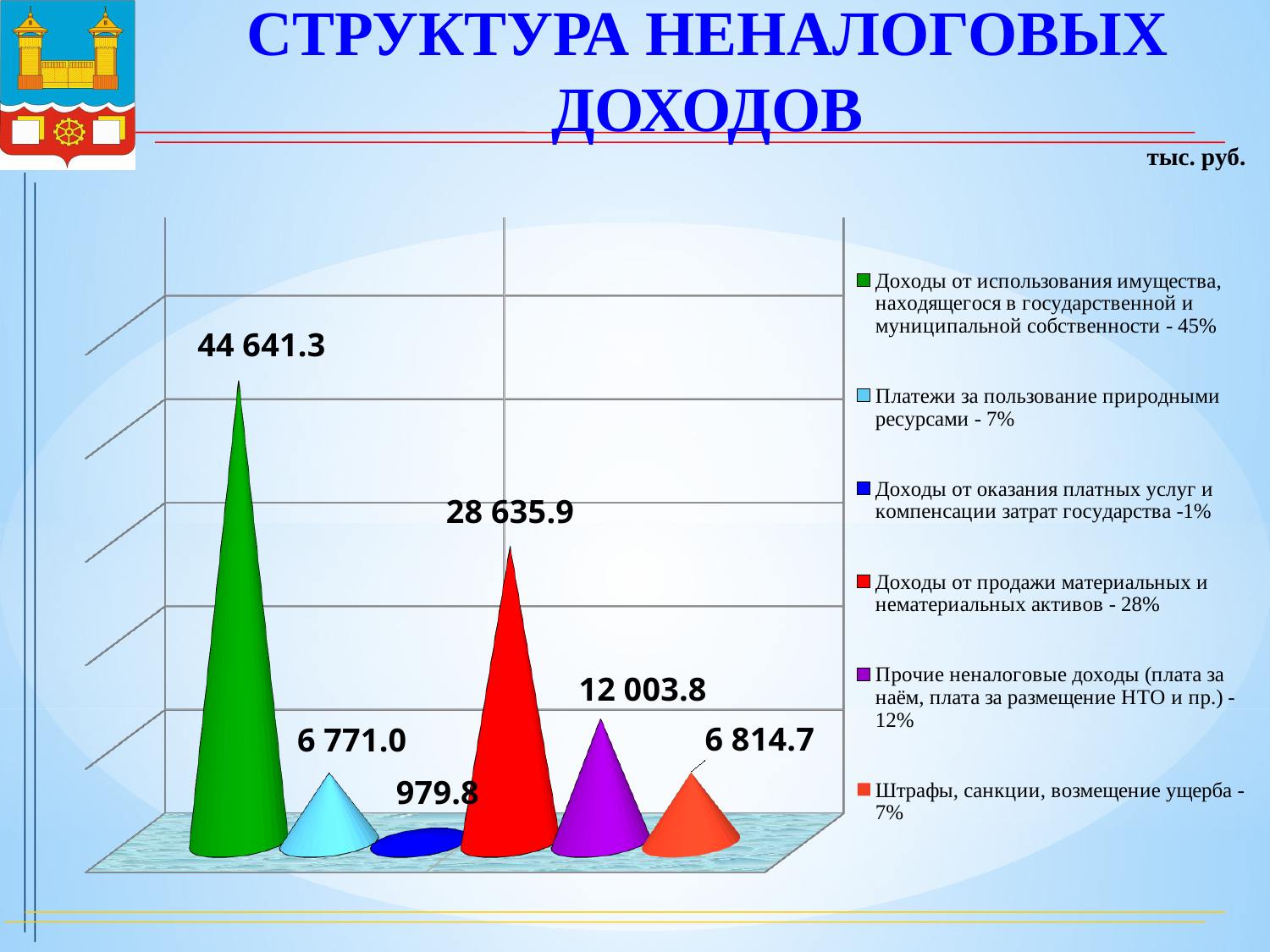
How many categories are plotted on the chart? 6 What unit of measurement is indicated for the chart values? тыс. руб. Which category has the lowest value? Доходы от оказания платных услуг и компенсации затрат государства What is the difference between the values for Доходы от использования имущества and Доходы от продажи материальных и нематериальных активов? 16 005.4 What is the difference between the values for Штрафы, санкции, возмещение ущерба and Платежи за пользование природными ресурсами? 43.7 What is the value for Штрафы, санкции, возмещение ущерба? 6 814.7 What kind of chart is shown on the slide? Bar chart What is the value for Доходы от использования имущества, находящегося в государственной и муниципальной собственности? 44 641.3 What is the value for Доходы от продажи материальных и нематериальных активов? 28 635.9 Which is larger: the value for Доходы от продажи материальных и нематериальных активов or the value for Прочие неналоговые доходы? Доходы от продажи материальных и нематериальных активов What is the value for Прочие неналоговые доходы (плата за наём, плата за размещение НТО и пр.)? 12 003.8 Which category has the highest value? Доходы от использования имущества, находящегося в государственной и муниципальной собственности